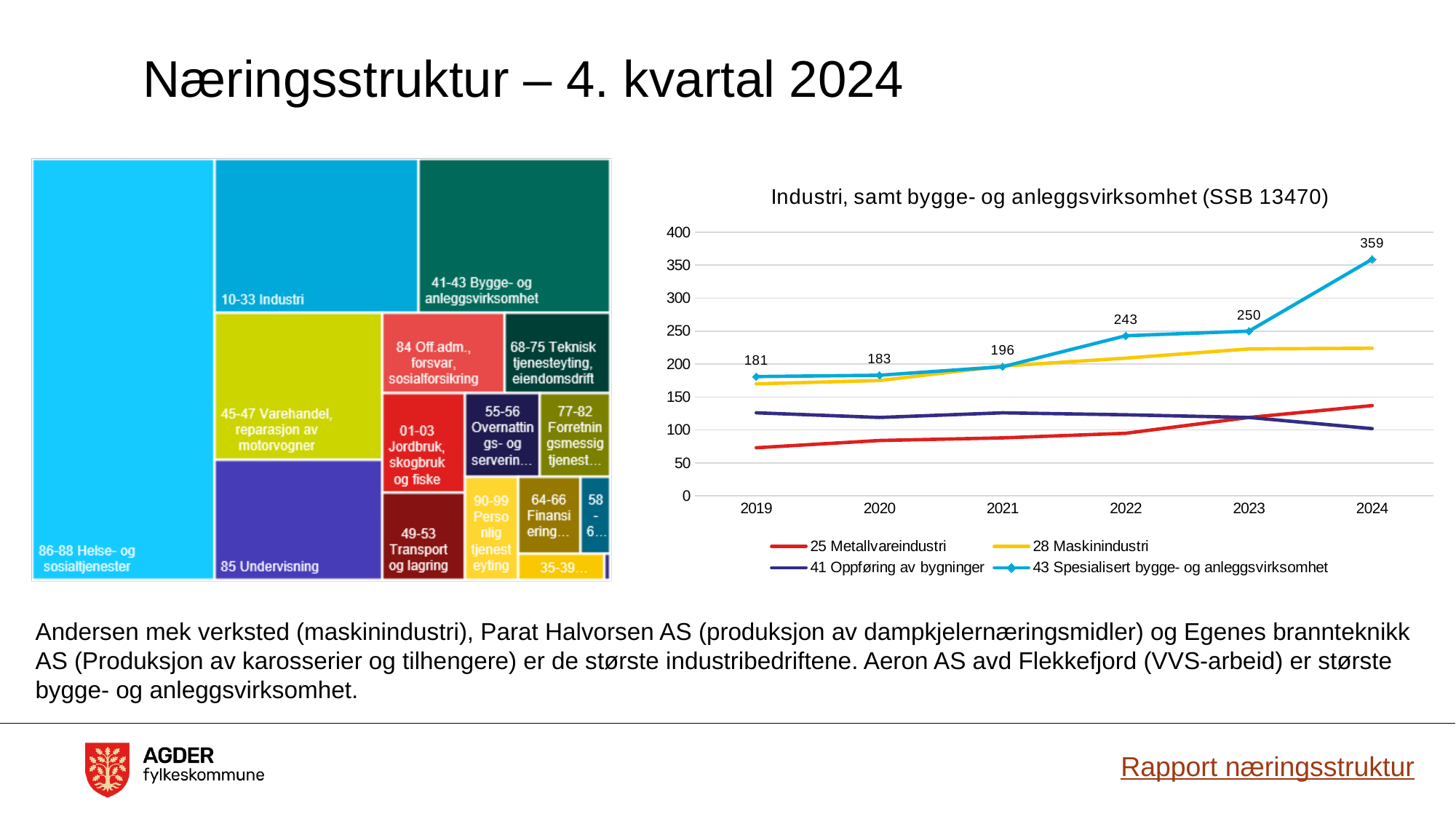
In the chart on the left of the slide, which category occupies the largest area? 86-88 Helse- og sosialtjenester In the line chart on the right, what is the value for 43 Spesialisert bygge- og anleggsvirksomhet in 2019? 181 In the line chart on the right, does the value for 43 Spesialisert bygge- og anleggsvirksomhet rise or fall from 2019 to 2024? rise In the line chart on the right, how many years are shown on the x axis? 6 In the line chart on the right, what is the value for 43 Spesialisert bygge- og anleggsvirksomhet in 2022? 243 In the line chart titled 'Industri, samt bygge- og anleggsvirksomhet (SSB 13470)', what is the value for 43 Spesialisert bygge- og anleggsvirksomhet in 2024? 359 In the line chart on the right, by how much did 43 Spesialisert bygge- og anleggsvirksomhet increase from 2023 to 2024? 109 In the line chart on the right, is the value for 25 Metallvareindustri in 2019 greater or less than 100? less In the line chart on the right, in which year is the value for 43 Spesialisert bygge- og anleggsvirksomhet lowest? 2019 In the line chart on the right, is the value for 28 Maskinindustri in 2024 greater or less than 200? greater In the line chart on the right, in which year does 43 Spesialisert bygge- og anleggsvirksomhet reach its highest value? 2024 In the line chart on the right, how many series does the legend list? 4